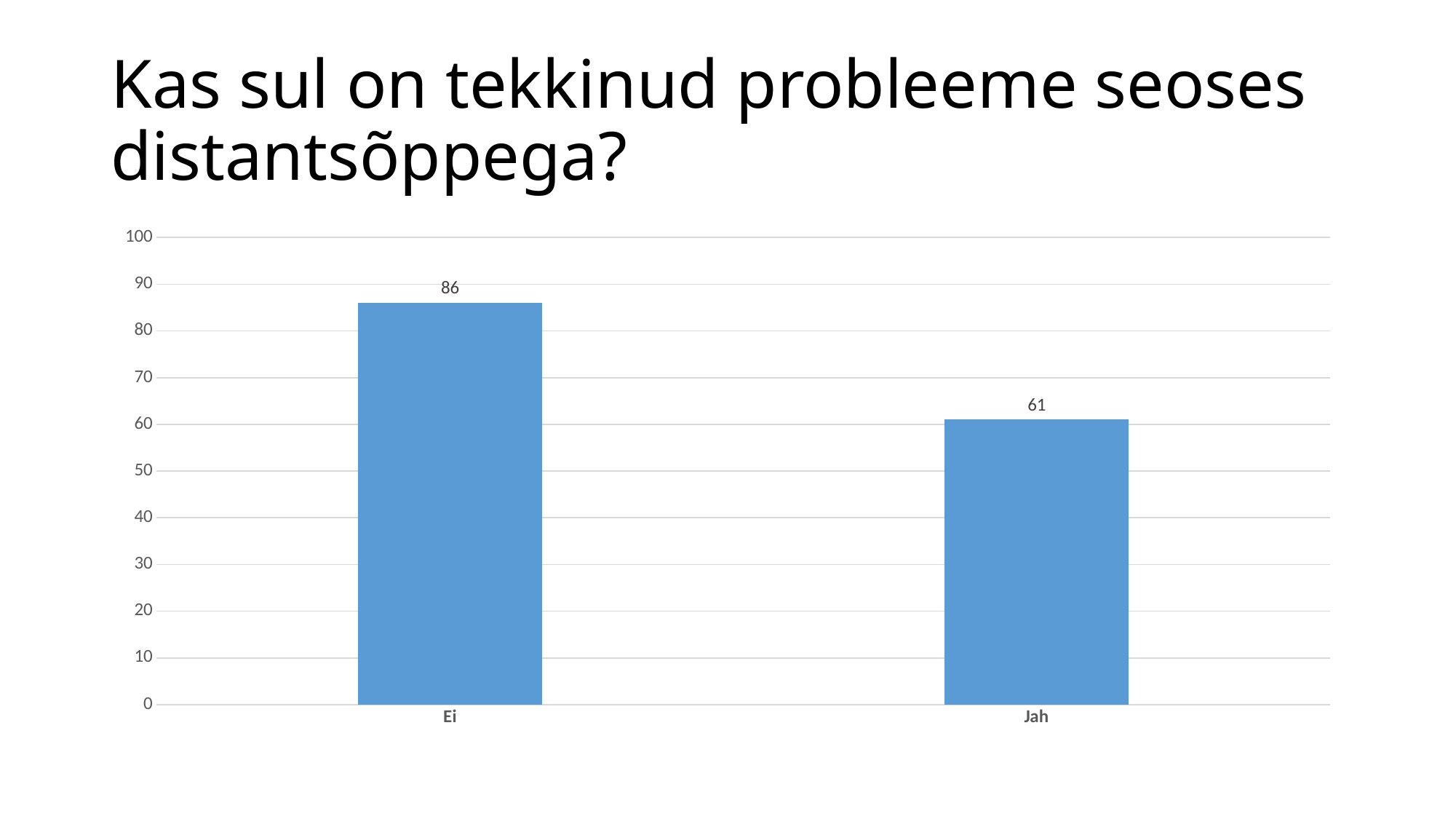
What is the total of the two bars? 147 Which is larger, the value for Ei or the value for Jah? Ei How many categories are shown on the chart? 2 Is the value for Ei greater or less than 80? greater Which category has the lowest value? Jah What is the title of the slide? Kas sul on tekkinud probleeme seoses distantsõppega? What is the value for Jah? 61 What is the value for Ei? 86 What kind of chart is shown on the slide? bar chart What is the difference between the values for Ei and Jah? 25 Is the value for Jah greater or less than 70? less Which category has the highest value? Ei